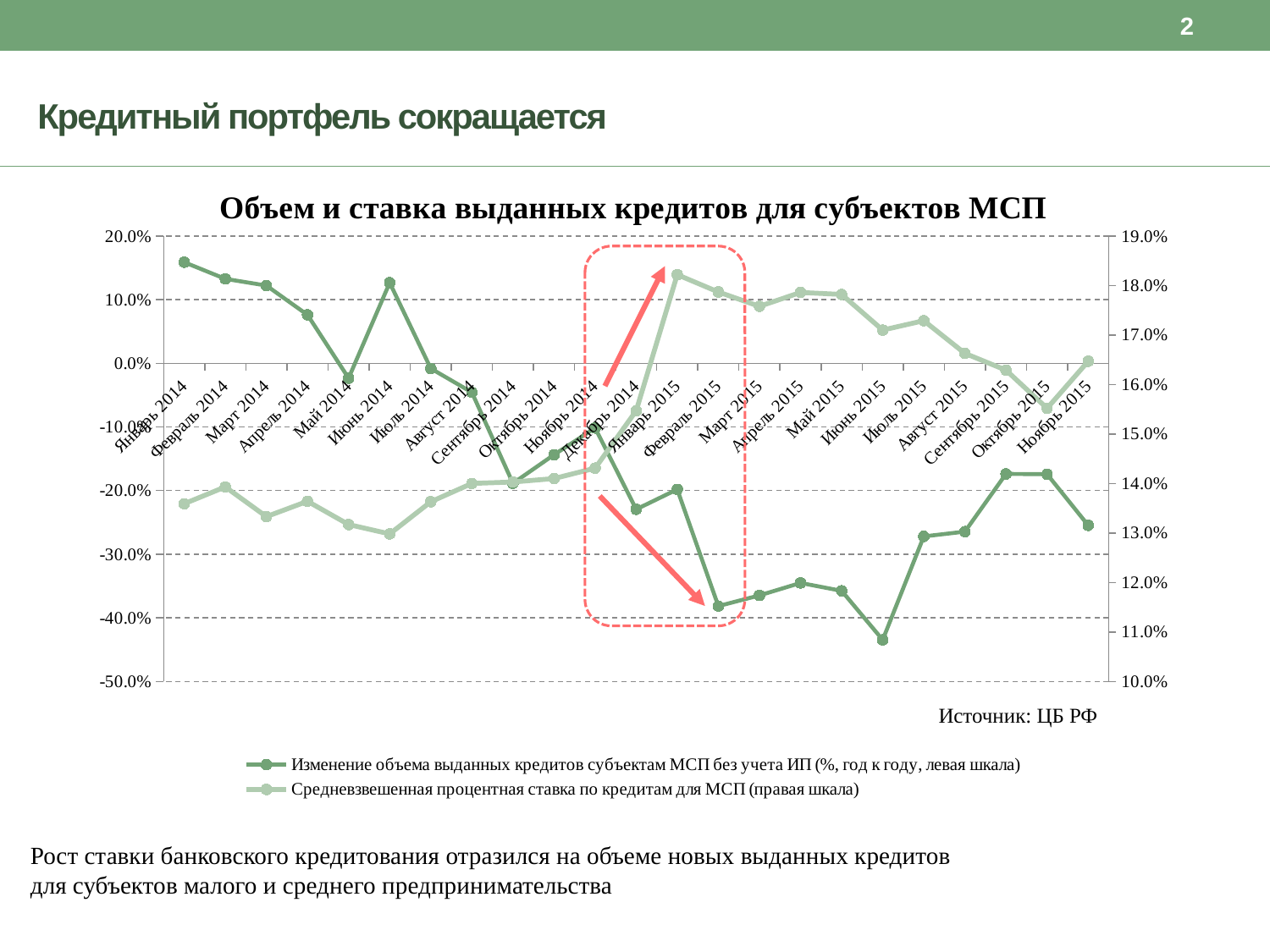
What is the title of the chart? Объем и ставка выданных кредитов для субъектов МСП Is the weighted average interest rate for Январь 2015 greater or less than 17.0%? greater What kind of chart is shown on the slide? Line chart Is the change in volume of loans issued for Июнь 2015 greater or less than -40.0%? less How many months are plotted along the x axis? 23 In which month is the weighted average interest rate (right scale) lowest? Июнь 2014 Is the change in volume of loans issued for Январь 2014 greater or less than 10.0%? greater How many series does the legend list? 2 Which month has the larger change in volume of loans issued: Январь 2014 or Февраль 2014? Январь 2014 In which month is the change in volume of loans issued to SMEs (left scale) highest? Январь 2014 In which month is the change in volume of loans issued to SMEs (left scale) lowest? Июнь 2015 In which month is the weighted average interest rate (right scale) highest? Январь 2015